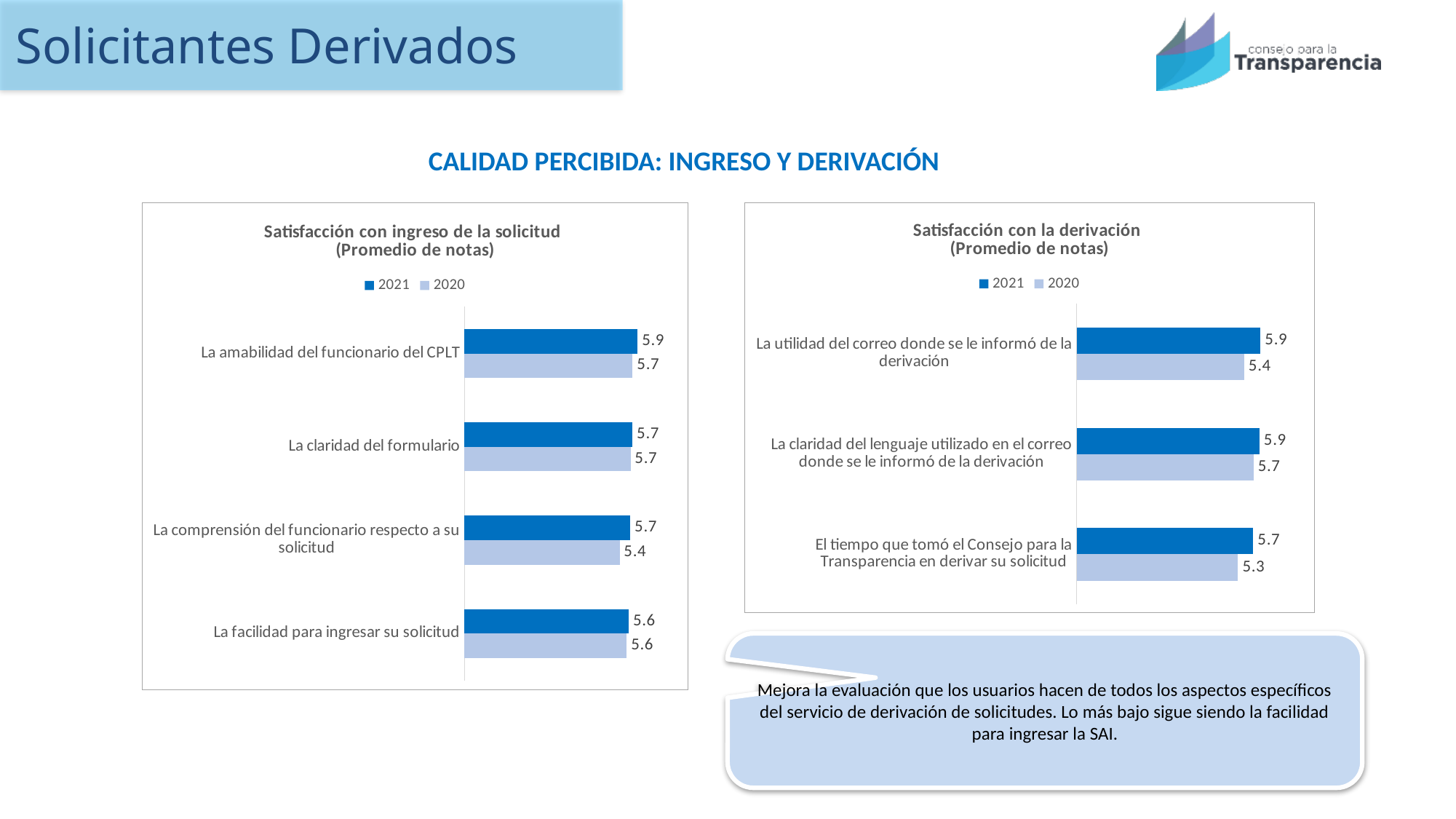
How many series does the legend list in the chart 'Satisfacción con la derivación'? 2 What kind of chart is 'Satisfacción con la derivación'? bar chart In the chart 'Satisfacción con la derivación', what is the difference between the 2021 and 2020 values for 'La utilidad del correo donde se le informó de la derivación'? 0.5 In the chart 'Satisfacción con ingreso de la solicitud', which category has the lowest 2021 value? La facilidad para ingresar su solicitud In the chart 'Satisfacción con ingreso de la solicitud', what is the 2021 value for 'La amabilidad del funcionario del CPLT'? 5.9 Which series is shown in the darker blue colour in the chart 'Satisfacción con ingreso de la solicitud'? 2021 In the chart 'Satisfacción con la derivación', what is the 2021 value for 'La claridad del lenguaje utilizado en el correo donde se le informó de la derivación'? 5.9 How many categories are shown in the chart 'Satisfacción con ingreso de la solicitud'? 4 In the chart 'Satisfacción con la derivación', which category has the lowest 2020 value? El tiempo que tomó el Consejo para la Transparencia en derivar su solicitud In the chart 'Satisfacción con ingreso de la solicitud', what is the 2020 value for 'La comprensión del funcionario respecto a su solicitud'? 5.4 In the chart 'Satisfacción con la derivación', what is the 2020 value for 'El tiempo que tomó el Consejo para la Transparencia en derivar su solicitud'? 5.3 In the chart 'Satisfacción con ingreso de la solicitud', is the 2021 value for 'La amabilidad del funcionario del CPLT' larger or smaller than its 2020 value? larger